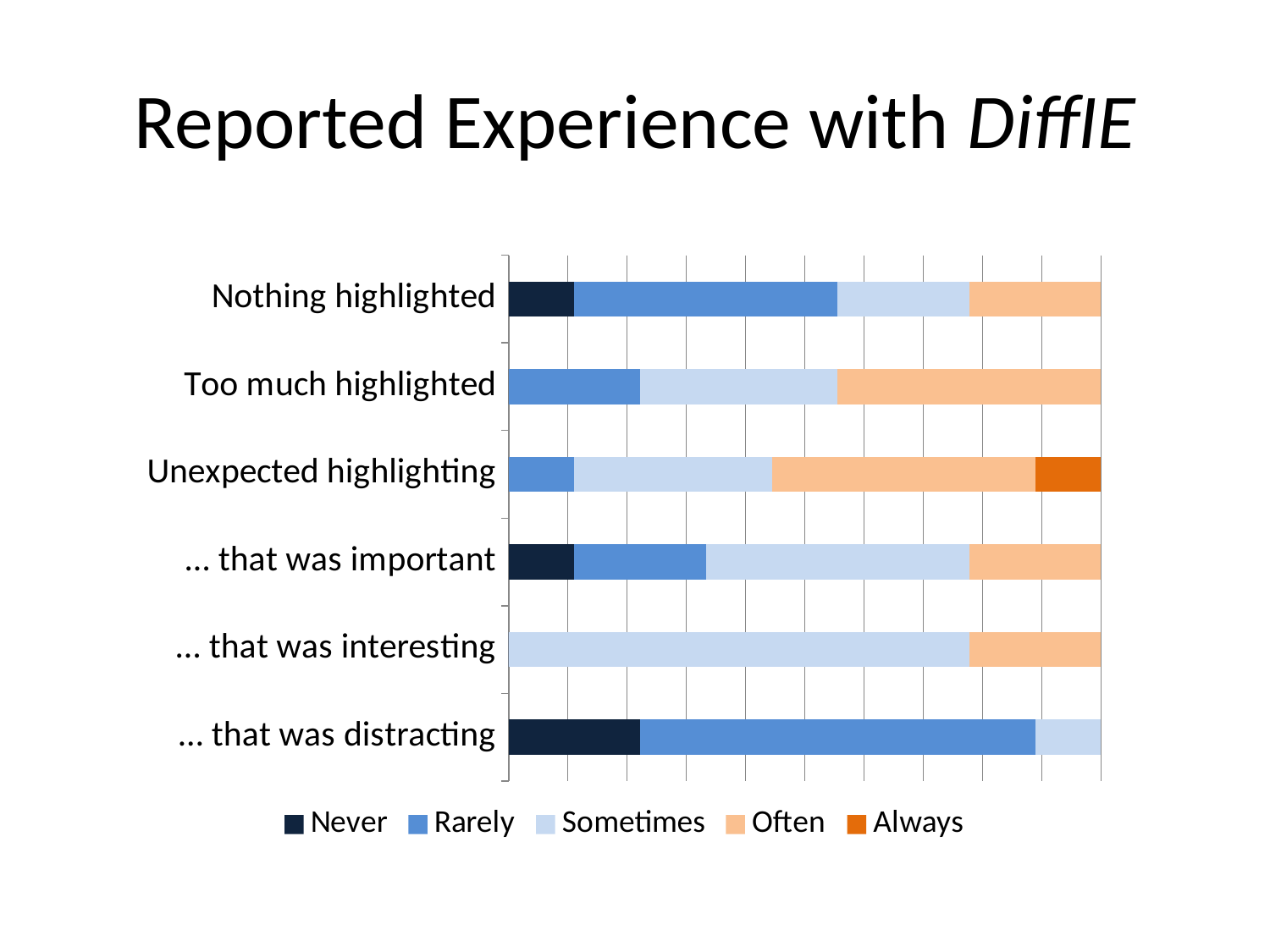
What are the legend entries of the chart? Never, Rarely, Sometimes, Often, Always Which category is the only one with an 'Always' segment? Unexpected highlighting For '... that was important', which segment is larger: 'Sometimes' or 'Often'? Sometimes Which category has the largest 'Never' segment? ... that was distracting How many categories are plotted on the chart? 6 For 'Nothing highlighted', which segment is larger: 'Rarely' or 'Sometimes'? Rarely For 'Too much highlighted', which response makes up the largest segment of the bar? Often What is the title of the slide? Reported Experience with DiffIE How many series does the legend list? 5 What kind of chart is shown on the slide? bar chart